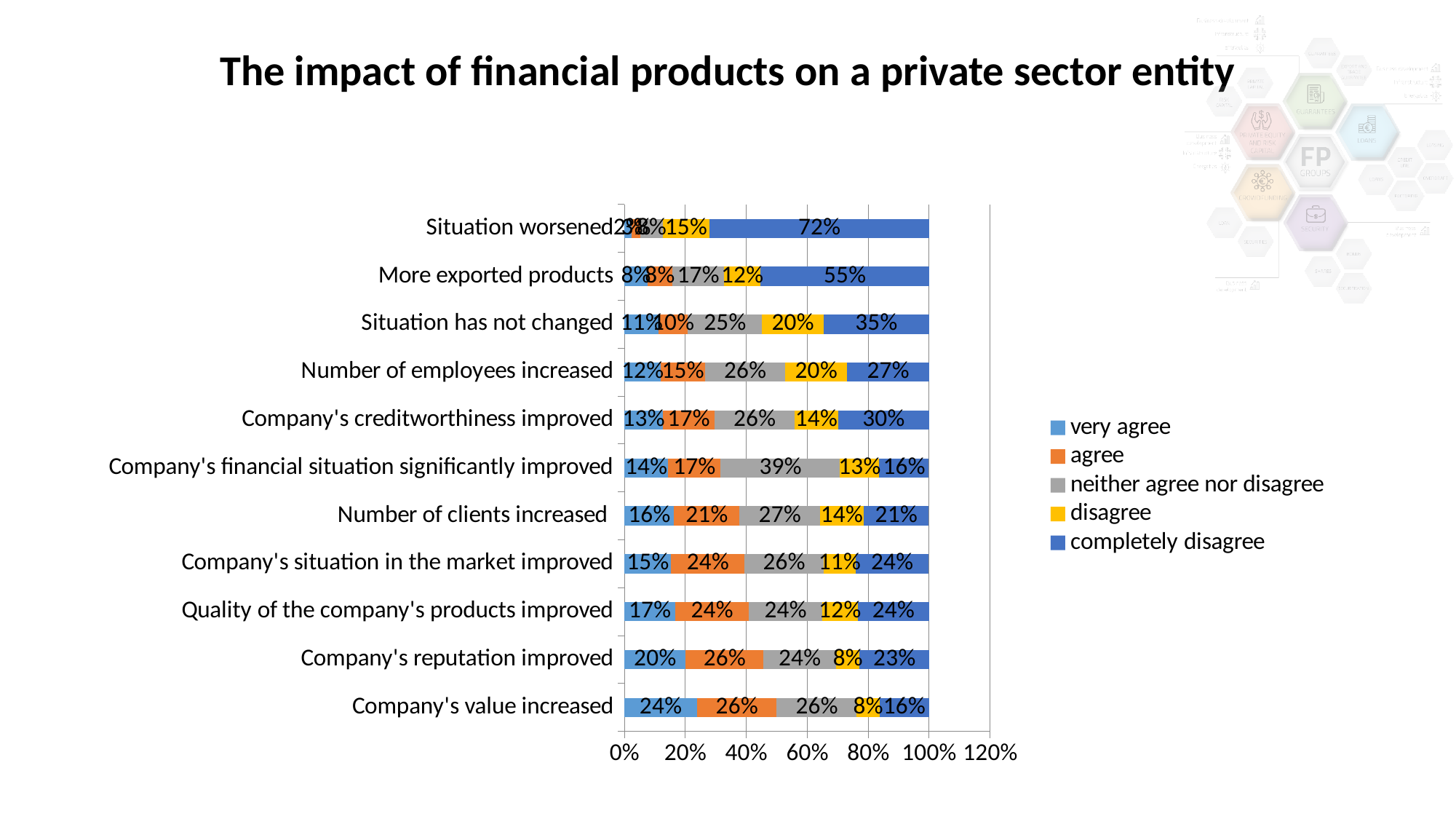
How many series does the legend list? 5 How many categories are plotted on the chart? 11 What is the title of the chart? The impact of financial products on a private sector entity What kind of chart is shown on the slide? Stacked bar chart What is the 'completely disagree' value for 'Situation worsened'? 72% Which is larger: the 'agree' value for 'Company's reputation improved' or the 'agree' value for 'Number of clients increased'? Company's reputation improved Which category has the highest 'very agree' value? Company's value increased Which category has the highest 'completely disagree' value? Situation worsened What is the 'disagree' value for 'Situation has not changed'? 20% What is the difference between the 'completely disagree' values for 'More exported products' and 'Situation has not changed'? 20% What is the 'very agree' value for 'Company's value increased'? 24% What is the 'neither agree nor disagree' value for 'Company's financial situation significantly improved'? 39%